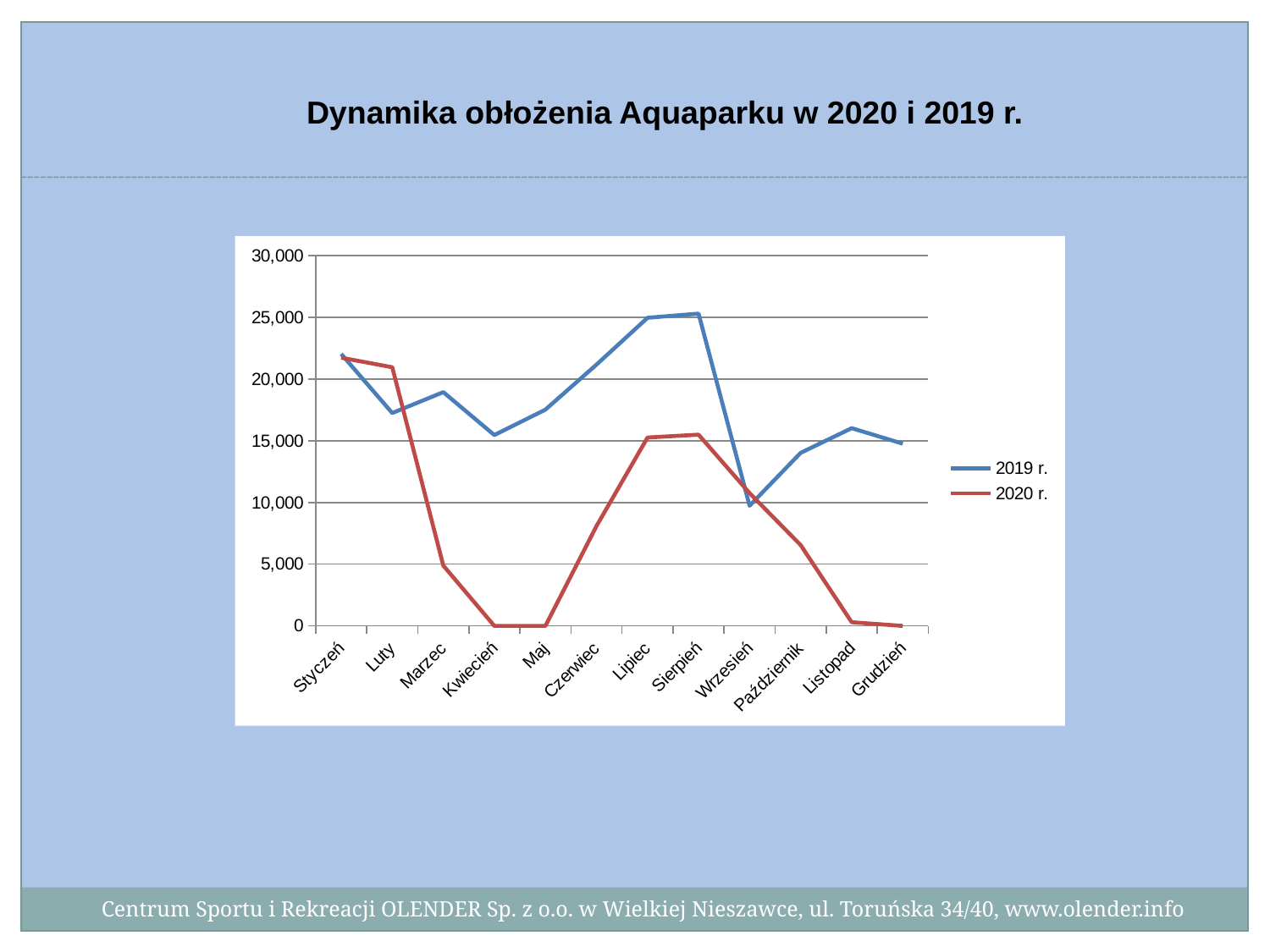
What type of chart is shown on the slide? line chart How many months are plotted along the x axis? 12 Is the value for Październik in the 2020 r. series greater or less than 10,000? less What is the title of the chart? Dynamika obłożenia Aquaparku w 2020 i 2019 r. Is the value for Lipiec in the 2019 r. series greater or less than 20,000? greater How many series does the legend list? 2 For Lipiec, which series has the larger value, 2019 r. or 2020 r.? 2019 r. What is the value for Kwiecień in the 2020 r. series? 0 Does the 2020 r. series rise or fall from Sierpień to Grudzień? fall Which series is drawn in red? 2020 r. Is the value for Marzec in the 2020 r. series greater or less than 10,000? less In which month is the 2019 r. series at its lowest? Wrzesień